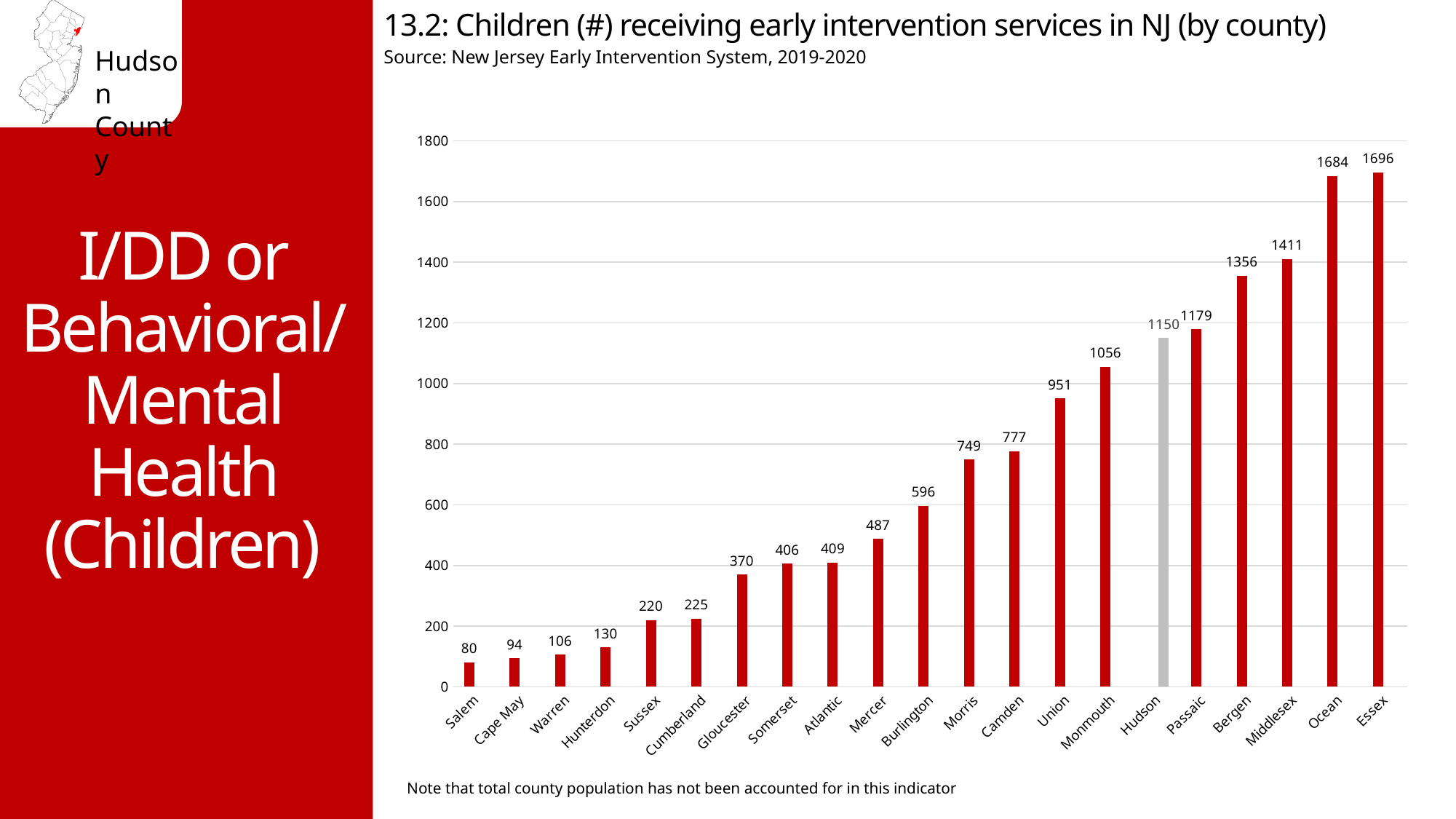
What is the difference between the values for Hudson and Monmouth? 94 What is the difference between the values for Essex and Ocean? 12 Is the value for Middlesex greater or less than 1400? greater How many children received early intervention services in Hudson County? 1150 Which county's bar is shown in gray rather than red? Hudson What kind of chart is shown on the slide? Bar chart How many counties are shown on the chart? 21 Which county has a larger value, Union or Camden? Union What is the value shown for Mercer County? 487 Which county has the highest number of children receiving early intervention services? Essex Which county has the lowest number of children receiving early intervention services? Salem What is the value shown for Bergen County? 1356